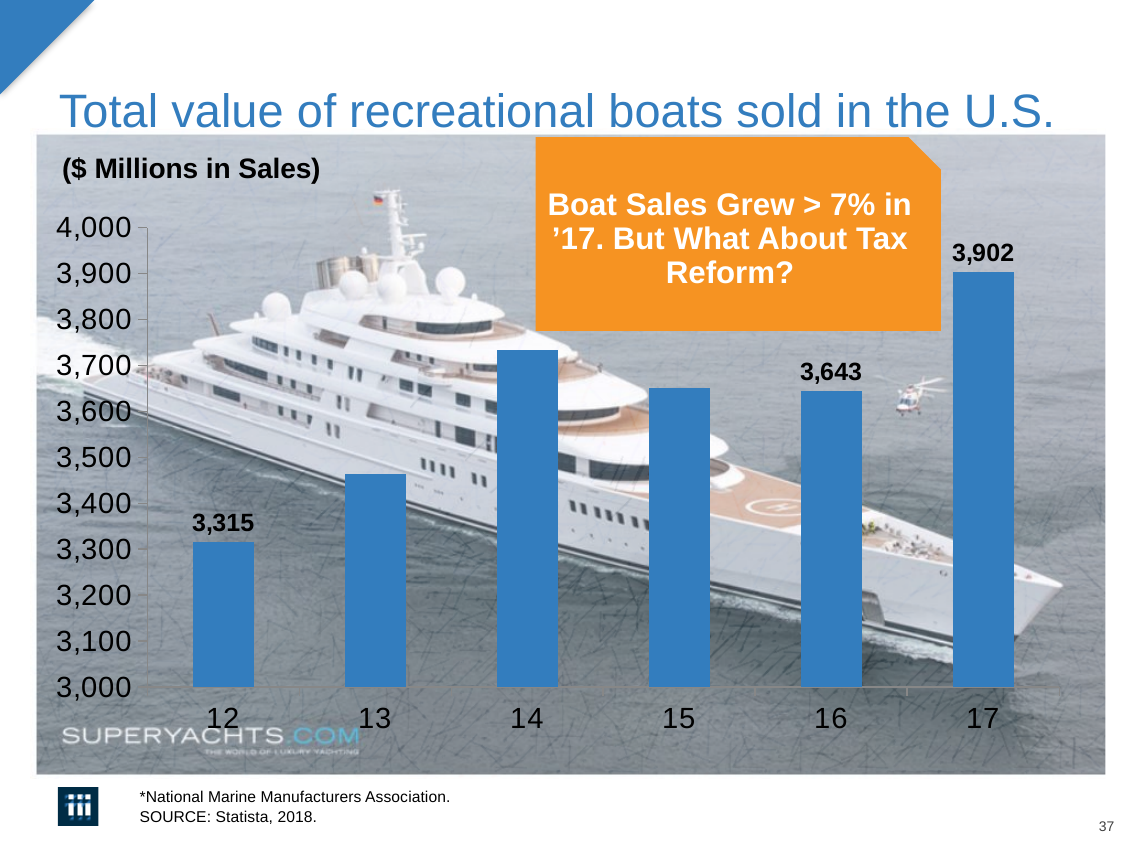
What is the difference between the values for 17 and 12? 587 How many years are shown on the x axis? 6 What is the value for 17? 3,902 What kind of chart is shown on the slide? bar chart Which year has the highest value? 17 What is the value for 16? 3,643 Which year has the lowest value? 12 What is the difference between the values for 17 and 16? 259 What is the value for 12? 3,315 Is the value for 13 greater or less than 3,500? less Which is larger, the value for 16 or the value for 17? 17 Is the value for 14 greater or less than 3,700? greater